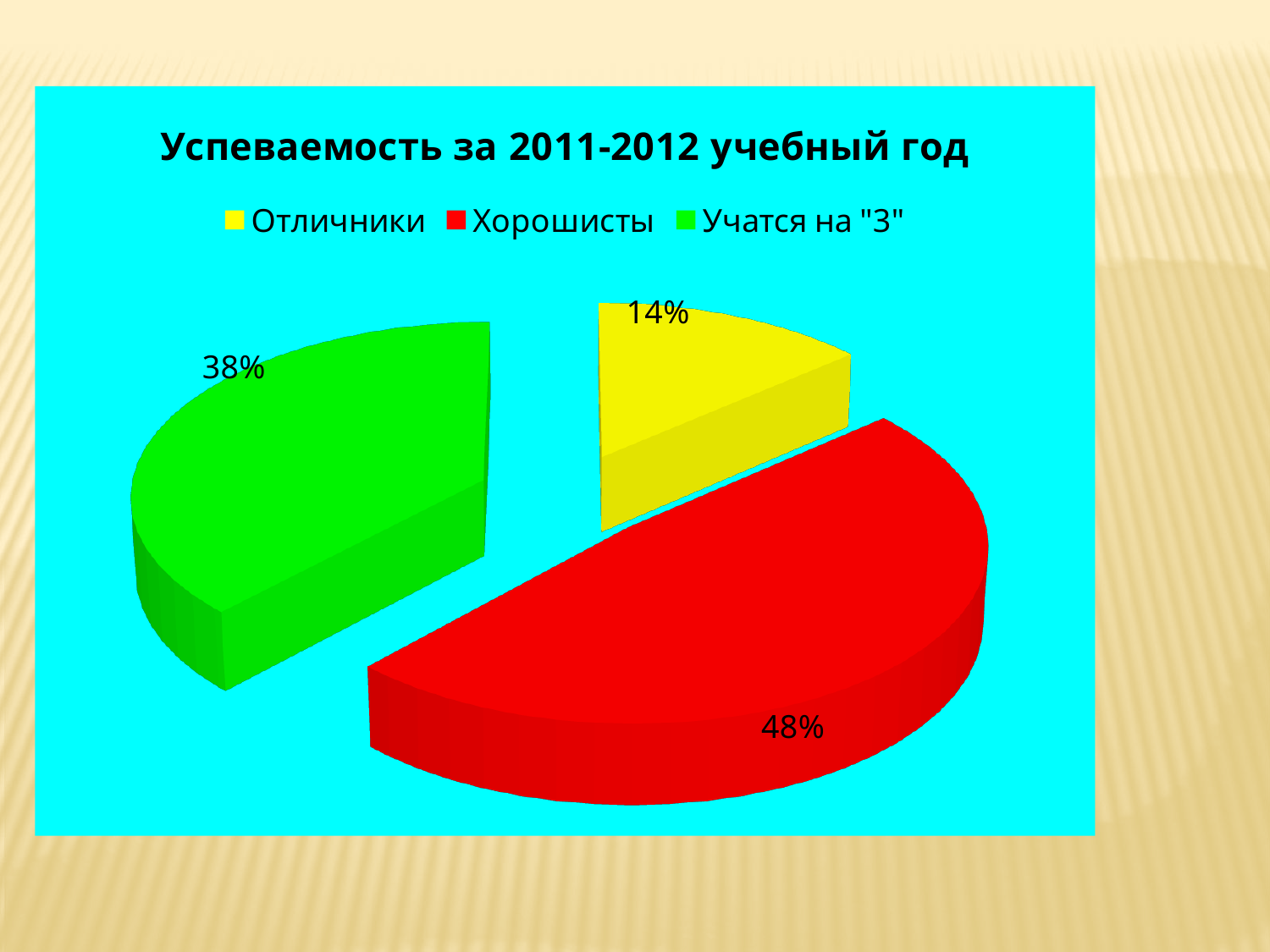
Which category has the largest slice of the pie? Хорошисты What is the difference in percentage points between Хорошисты and Учатся на "3"? 10 What share of the pie is labelled for Хорошисты? 48% Which is larger, the share for Учатся на "3" or the share for Отличники? Учатся на "3" What colour is the slice for Хорошисты? red What is the title of the chart? Успеваемость за 2011-2012 учебный год What share of the pie is labelled for Учатся на "3"? 38% What is the difference in percentage points between Хорошисты and Отличники? 34 What kind of chart is shown on the slide? pie chart How many categories does the pie chart have? 3 What share of the pie is labelled for Отличники? 14% Which category has the smallest slice of the pie? Отличники